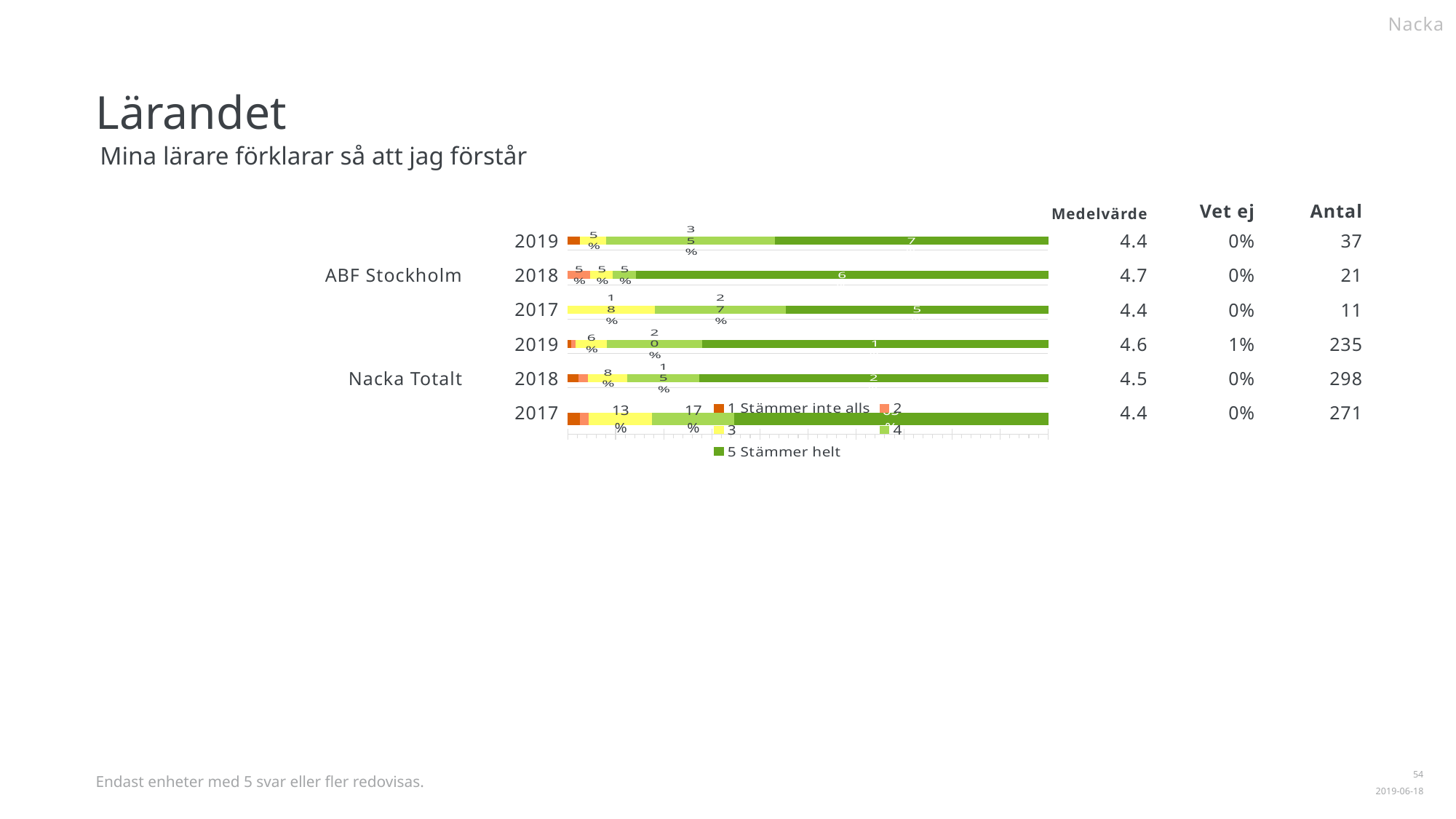
What is the value of the '3' segment for Nacka Totalt 2019? 6% Which bar has the longest '5 Stämmer helt' segment? ABF Stockholm 2018 What is the first entry in the chart legend? 1 Stämmer inte alls How many series does the chart legend list? 5 How many bars (year rows) are plotted in the chart? 6 What is the value of the '4' segment for ABF Stockholm 2017? 27% What kind of chart is shown on the slide? Stacked bar chart What is the difference between the '4' segment (27%) and the '3' segment (18%) for ABF Stockholm 2017? 9 percentage points What is the Medelvärde shown for ABF Stockholm 2018? 4.7 For Nacka Totalt 2017, which is larger: the '3' segment or the '4' segment? The '4' segment (17%) What is the value of the '3' segment for ABF Stockholm 2019? 5% What is the value of the '4' segment for Nacka Totalt 2017? 17%